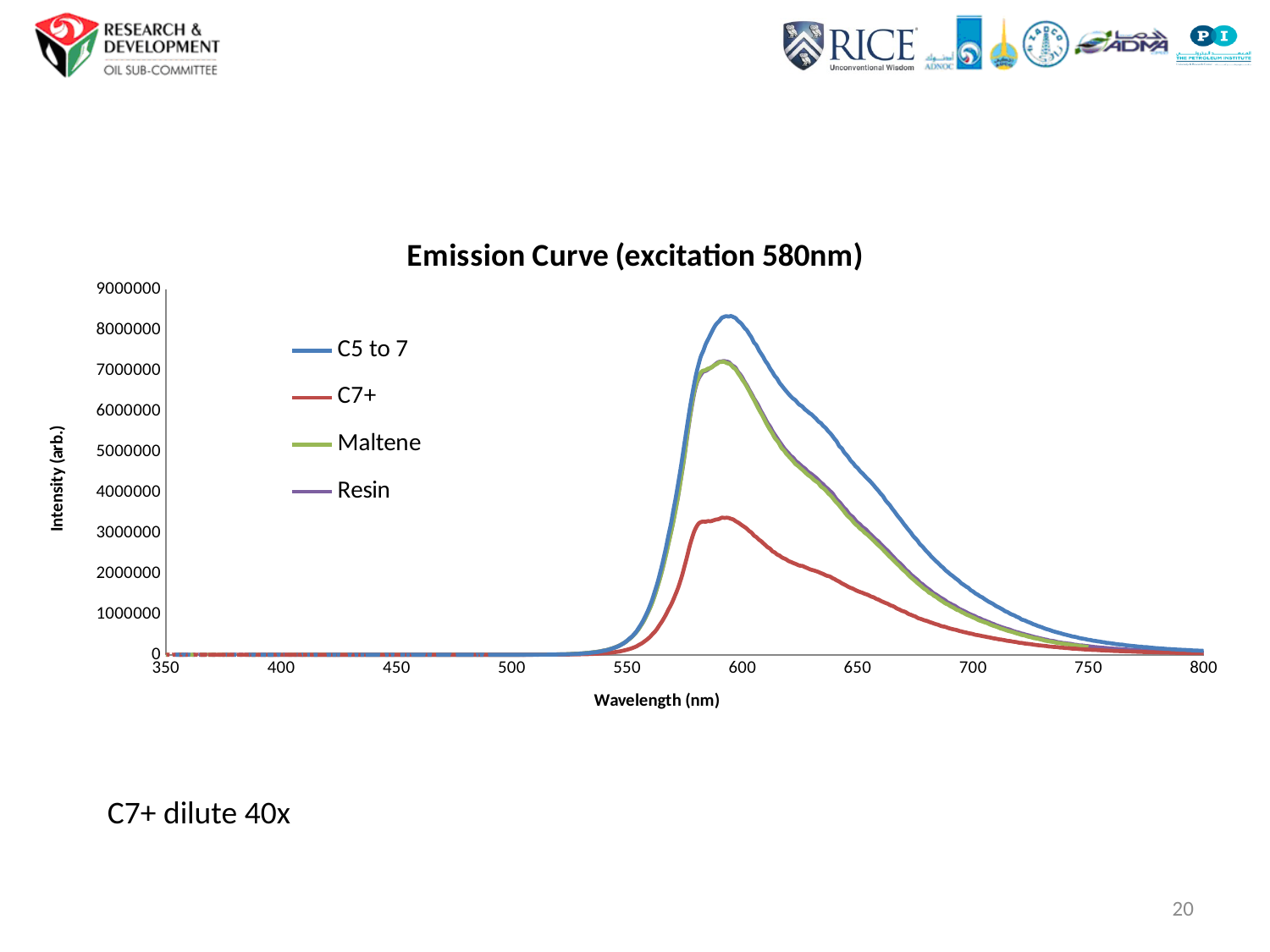
Is the intensity of the C5 to 7 series at 500 nm greater or less than 1000000? less What kind of chart is shown on the slide? line chart Is the peak value of the Maltene series greater or less than 6000000? greater What is the title of the chart? Emission Curve (excitation 580nm) Between 600 nm and 800 nm, do the intensity values rise or fall along the x axis? fall At a wavelength of 600 nm, which series has the larger intensity, C5 to 7 or C7+? C5 to 7 What is the label of the x axis? Wavelength (nm) How many series does the legend list? 4 Is the peak value of the C5 to 7 series greater or less than 8000000? greater Which series has the lowest peak intensity? C7+ Which series reaches the highest peak intensity? C5 to 7